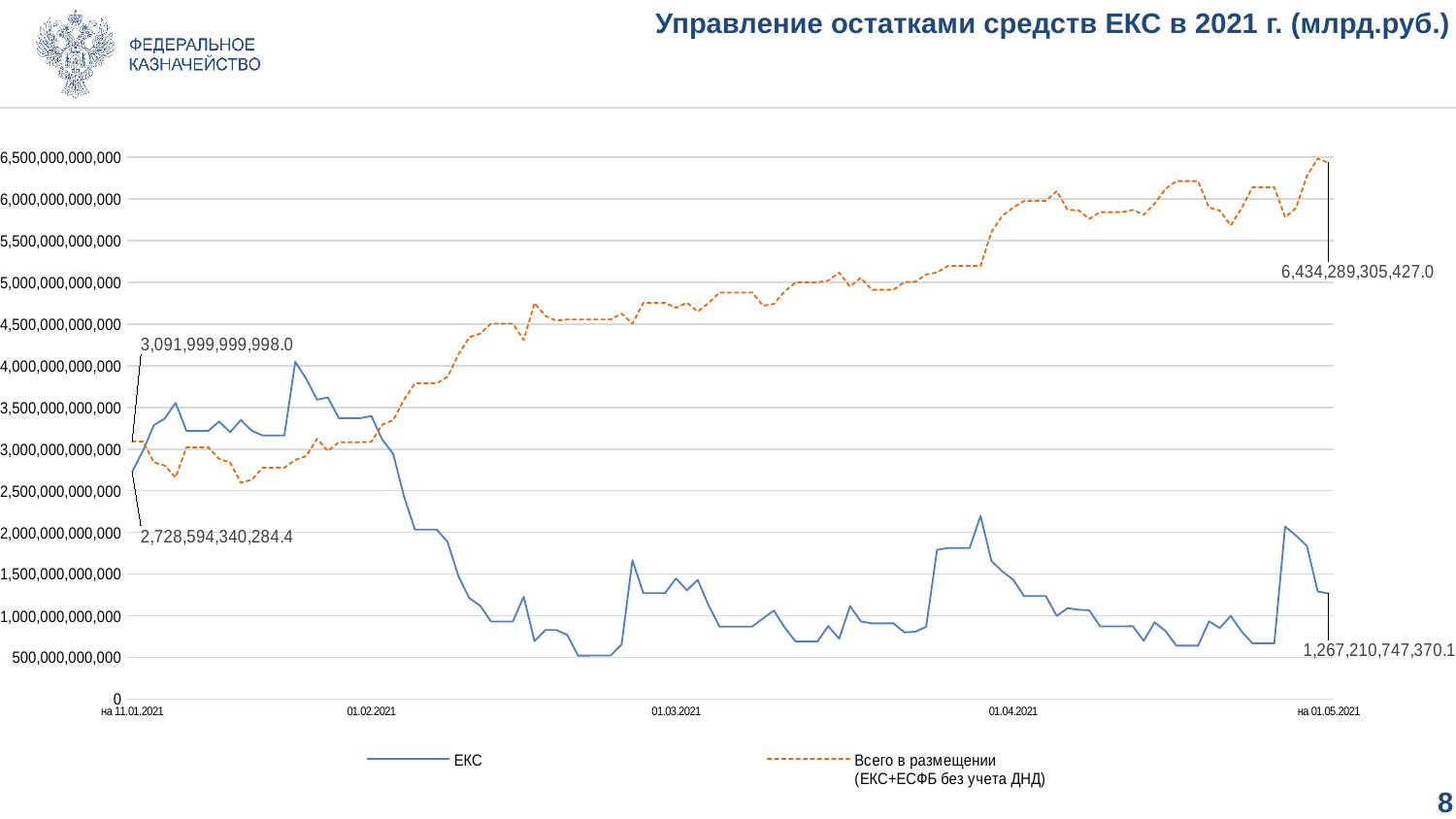
By how much did the ЕКС series decrease from 11.01.2021 to 01.05.2021? 1,461,383,592,914.3 Is the value of the Всего в размещении series on 01.03.2021 greater or less than 4,000,000,000,000? greater What is the value of the Всего в размещении series at the end of the chart (на 01.05.2021)? 6,434,289,305,427.0 How many series does the legend list? 2 Which series has the higher value on 01.05.2021, ЕКС or Всего в размещении? Всего в размещении What is the value of the ЕКС series at the start of the chart (на 11.01.2021)? 2,728,594,340,284.4 What is the value of the Всего в размещении series at the start of the chart (на 11.01.2021)? 3,091,999,999,998.0 By how much did the Всего в размещении series increase from 11.01.2021 to 01.05.2021? 3,342,289,305,429.0 Is the value of the ЕКС series on 01.02.2021 greater or less than 3,000,000,000,000? greater Does the Всего в размещении series generally rise or fall from 11.01.2021 to 01.05.2021? Rise What is the value of the ЕКС series at the end of the chart (на 01.05.2021)? 1,267,210,747,370.1 What kind of chart is shown on the slide? Line chart